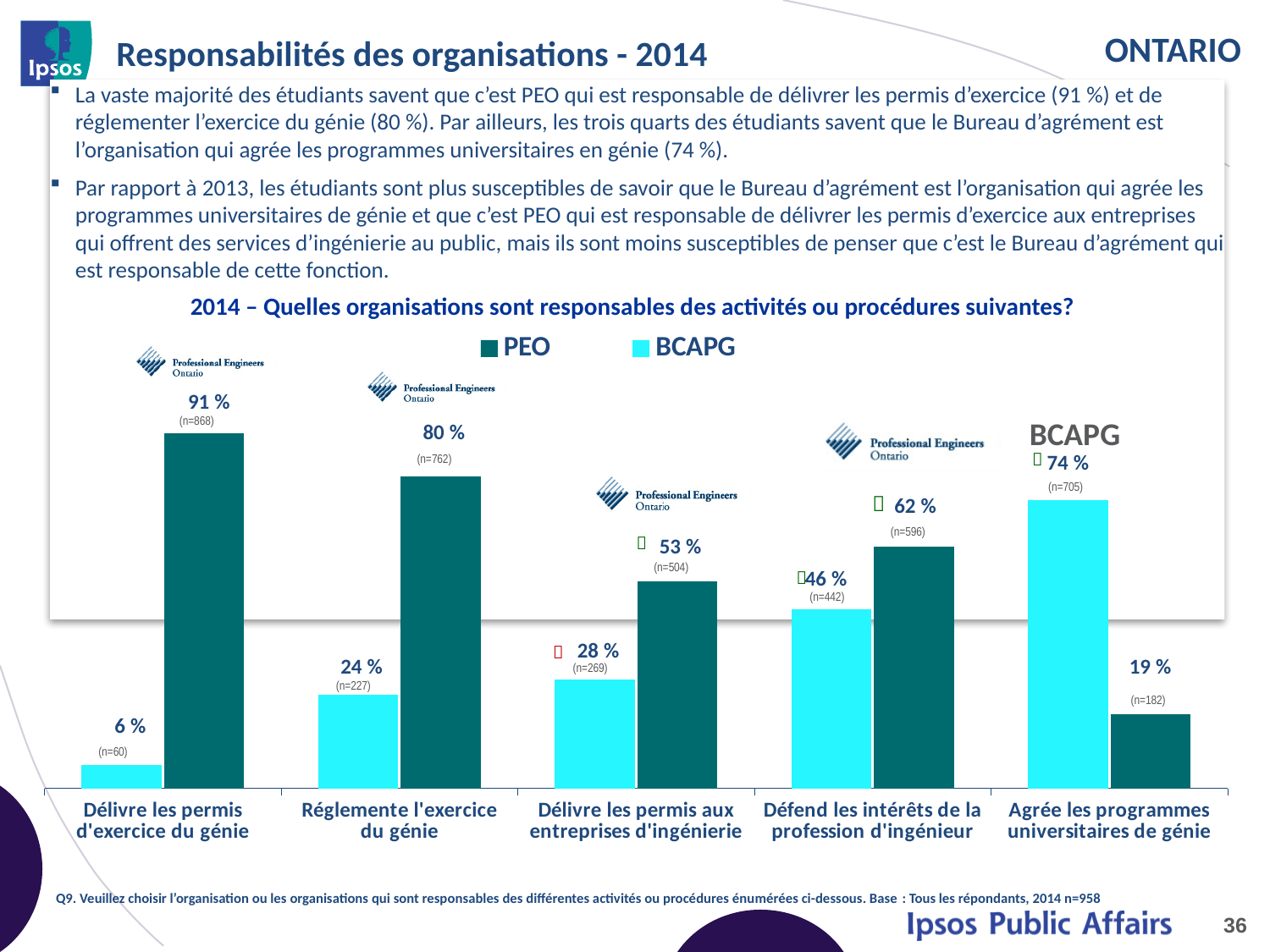
What is the BCAPG value for "Défend les intérêts de la profession d'ingénieur"? 46 % How many categories are shown on the x axis of the chart? 5 What is the PEO value for "Délivre les permis d'exercice du génie"? 91 % What is the PEO value for "Délivre les permis aux entreprises d'ingénierie"? 53 % What type of chart is shown on the slide? Bar chart What is the difference between the PEO and BCAPG values for "Réglemente l'exercice du génie"? 56 % Which category has the highest PEO value? Délivre les permis d'exercice du génie What is the BCAPG value for "Agrée les programmes universitaires de génie"? 74 % How many series does the chart legend list? 2 Which category has the lowest BCAPG value? Délivre les permis d'exercice du génie What is the title of the chart? 2014 – Quelles organisations sont responsables des activités ou procédures suivantes? For "Agrée les programmes universitaires de génie", which series has the larger value, PEO or BCAPG? BCAPG